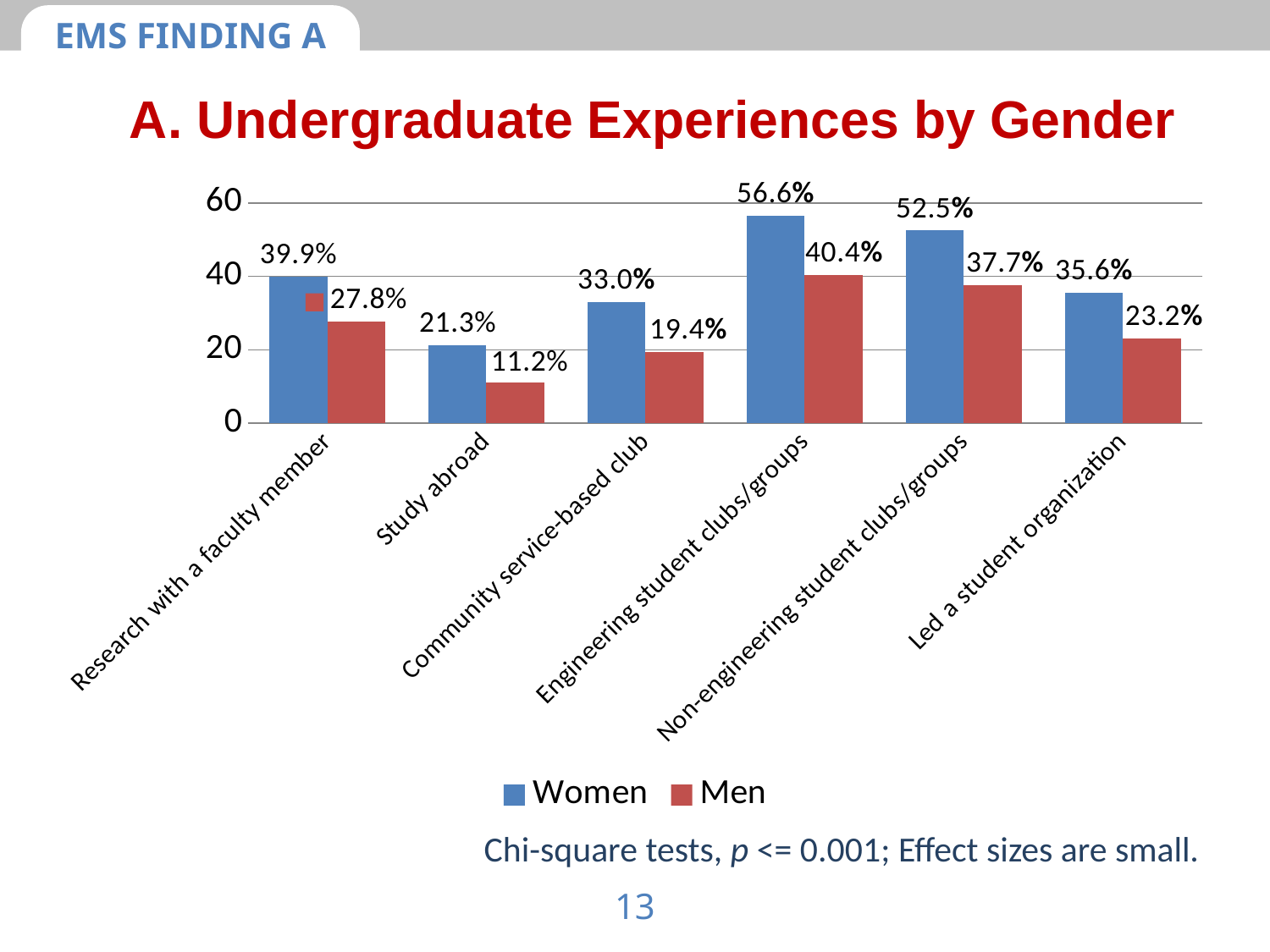
Which colour represents Men in the chart? Red How many series does the legend list? 2 What percentage of women reported research with a faculty member? 39.9% What is the difference between women and men for Led a student organization? 12.4% Which is larger: the women's value for Community service-based club or the men's value for Research with a faculty member? Women's value for Community service-based club What kind of chart is shown on the slide? Bar chart Which category has the highest value for women? Engineering student clubs/groups Which category has the lowest value for men? Study abroad How many categories are shown on the x axis? 6 What is the value for men in the Non-engineering student clubs/groups category? 37.7% What is the difference between women and men for Engineering student clubs/groups? 16.2% What percentage of men reported study abroad? 11.2%